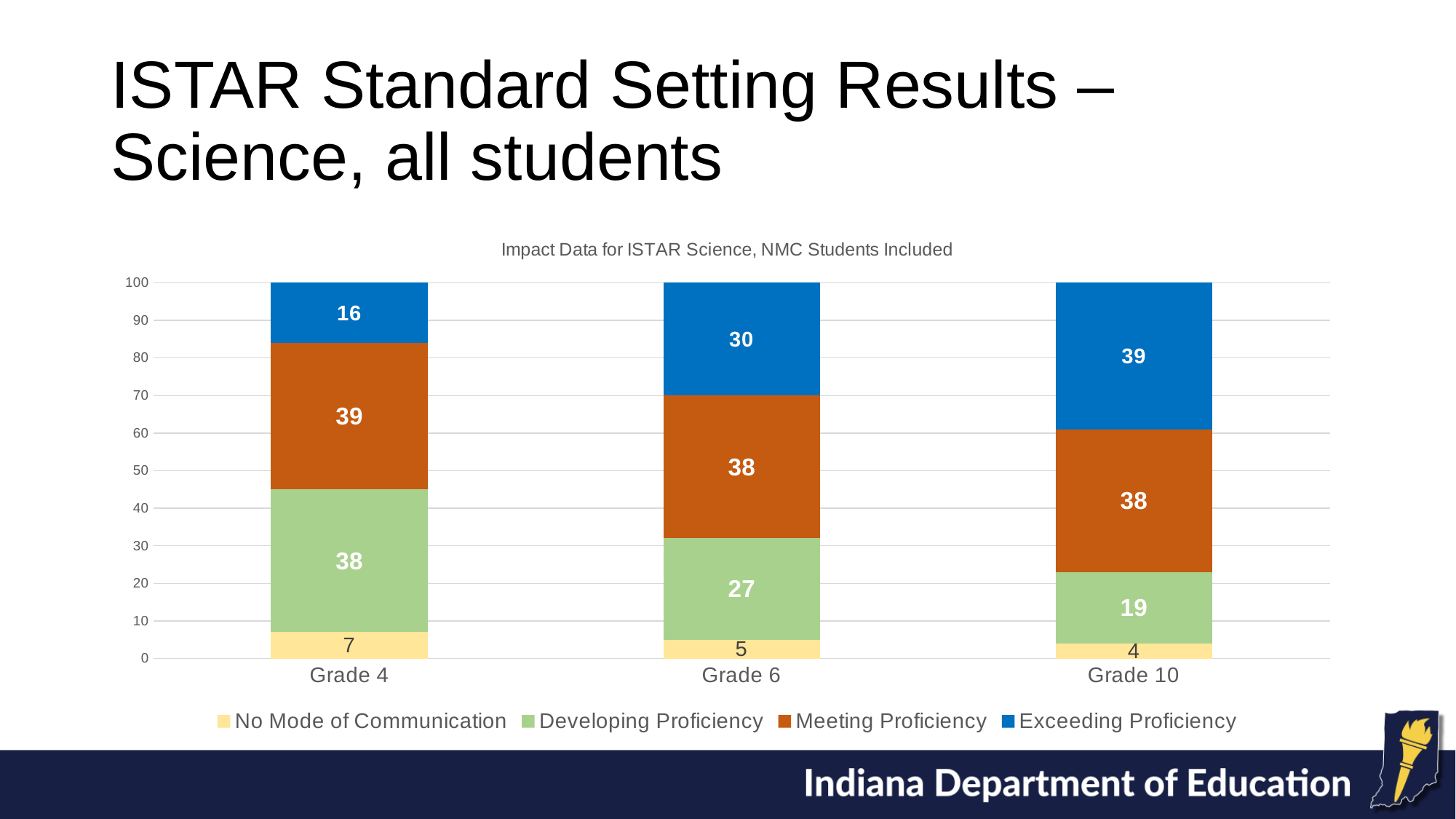
Which grade has the lowest value for Developing Proficiency? Grade 10 What is the value for Developing Proficiency in Grade 6? 27 Which is larger, Developing Proficiency in Grade 4 or Developing Proficiency in Grade 6? Grade 4 Does the Exceeding Proficiency value rise or fall from Grade 4 to Grade 10? Rise What is the difference between the Exceeding Proficiency values for Grade 10 and Grade 4? 23 How many grade categories are shown on the x axis? 3 Which grade has the highest value for Exceeding Proficiency? Grade 10 What is the value for Exceeding Proficiency in Grade 10? 39 What is the value for No Mode of Communication in Grade 4? 7 What is the value for Meeting Proficiency in Grade 4? 39 What kind of chart is shown on the slide? Stacked bar chart How many series does the legend list? 4